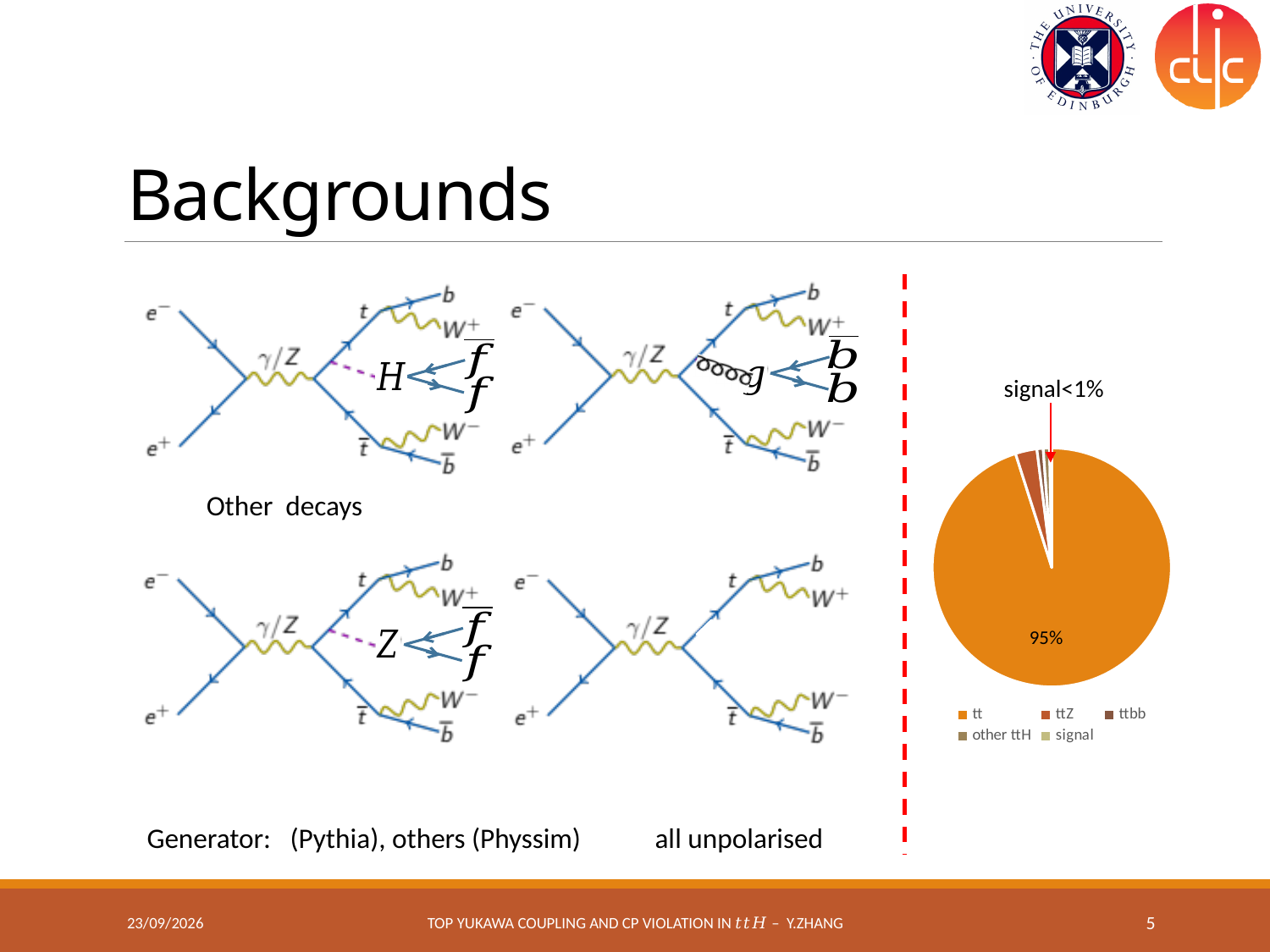
What colour is the largest slice of the pie chart? orange How many slices does the pie chart have? 5 What are the five legend entries of the pie chart? tt, ttZ, ttbb, other ttH, signal What percentage is printed on the tt slice of the pie chart? 95% What kind of chart is shown on the right side of the slide? pie chart Which is larger in the pie chart, the tt slice or the ttZ slice? tt What share of the pie chart does the tt category take? 95% According to the annotation on the pie chart, what is the share of the signal category? <1% How many categories does the legend of the pie chart list? 5 Which category has the largest slice in the pie chart? tt